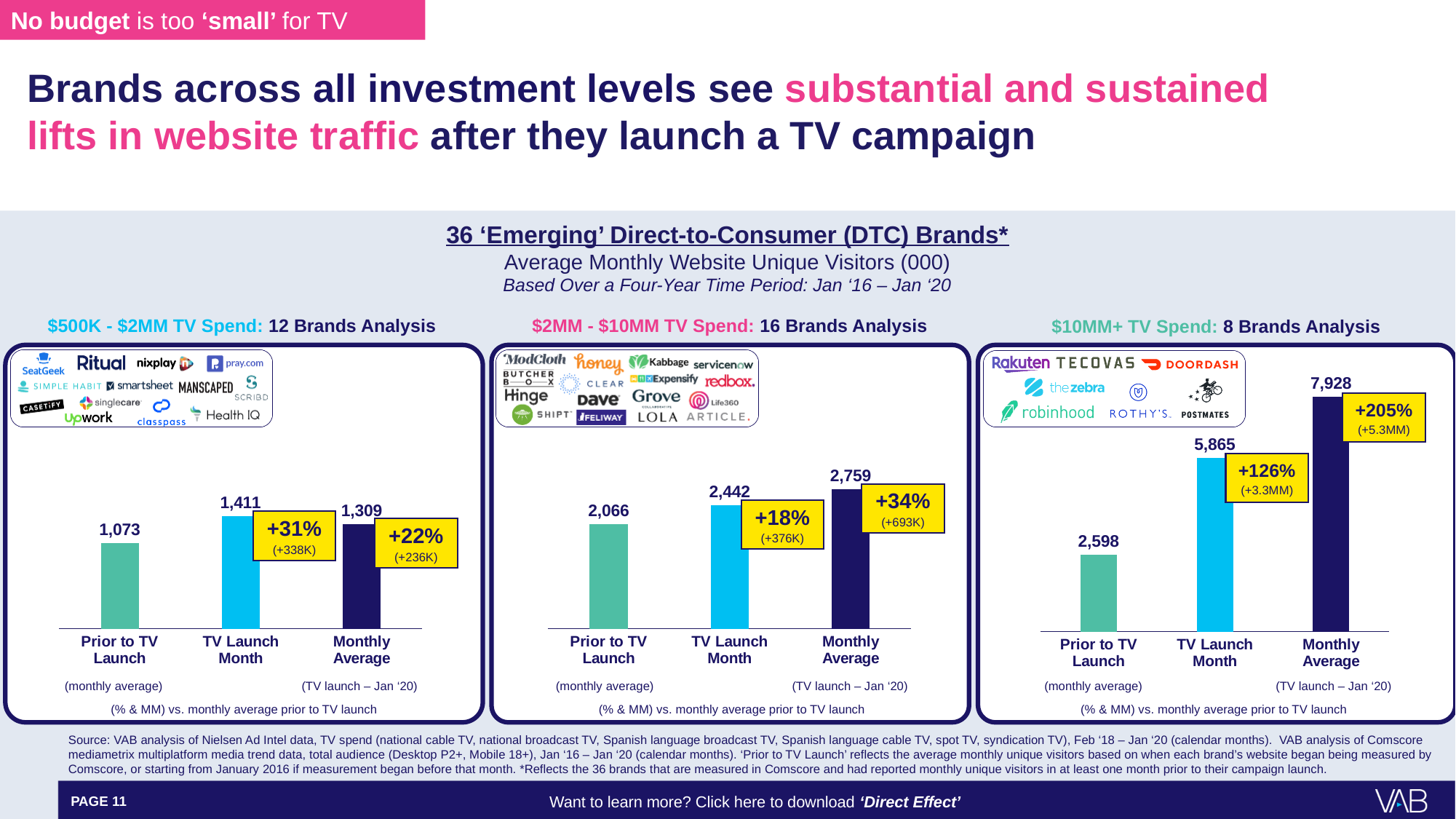
How many brands are included in the $10MM+ TV Spend analysis? 8 In the $2MM - $10MM TV Spend chart, what is the difference between Monthly Average and Prior to TV Launch? 693 In the $2MM - $10MM TV Spend chart, do the values rise or fall from Prior to TV Launch to Monthly Average? Rise In the $500K - $2MM TV Spend chart, which is larger: TV Launch Month or Monthly Average? TV Launch Month In the $10MM+ TV Spend chart, which category has the lowest value? Prior to TV Launch In the $10MM+ TV Spend chart, what is the value for Monthly Average? 7,928 In the $500K - $2MM TV Spend chart, which category has the highest value? TV Launch Month What kind of chart is the $10MM+ TV Spend chart? Bar chart In the $10MM+ TV Spend chart, what is the difference between TV Launch Month and Prior to TV Launch? 3,267 In the $500K - $2MM TV Spend chart, what is the value for TV Launch Month? 1,411 How many categories are shown in the $2MM - $10MM TV Spend chart? 3 In the $2MM - $10MM TV Spend chart, what is the value for Prior to TV Launch? 2,066